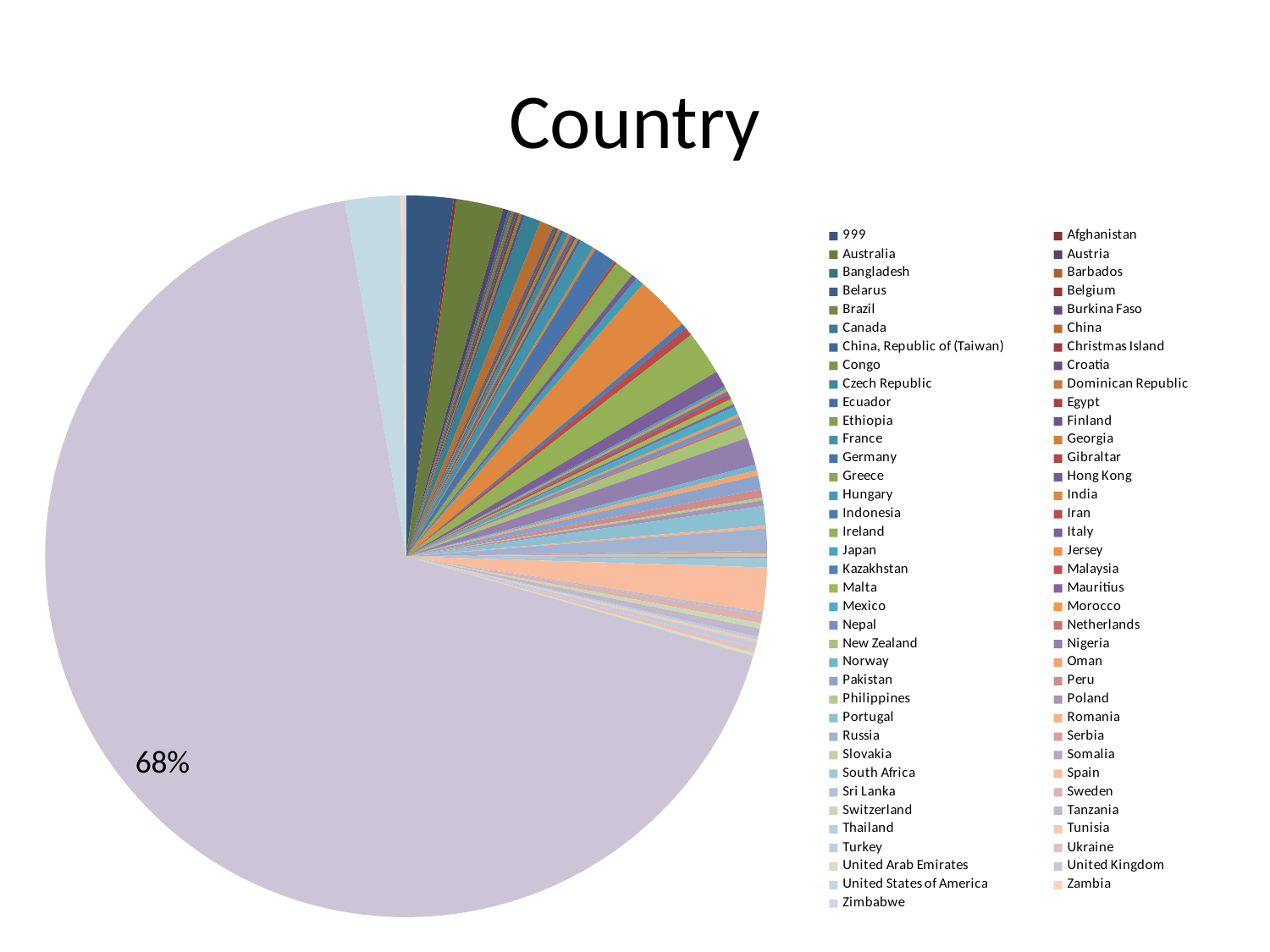
What is the first entry listed in the legend? 999 What is the title of the chart? Country Does the largest slice account for more or less than two thirds of the pie? more Which country does the largest slice of the pie (labelled 68%) represent? United Kingdom What percentage is printed on the largest slice of the pie? 68% What kind of chart is shown on the slide? pie chart Is the share of the largest slice greater or less than 50%? greater Which slice is larger, United Kingdom or United States of America? United Kingdom How many entries does the legend list? 73